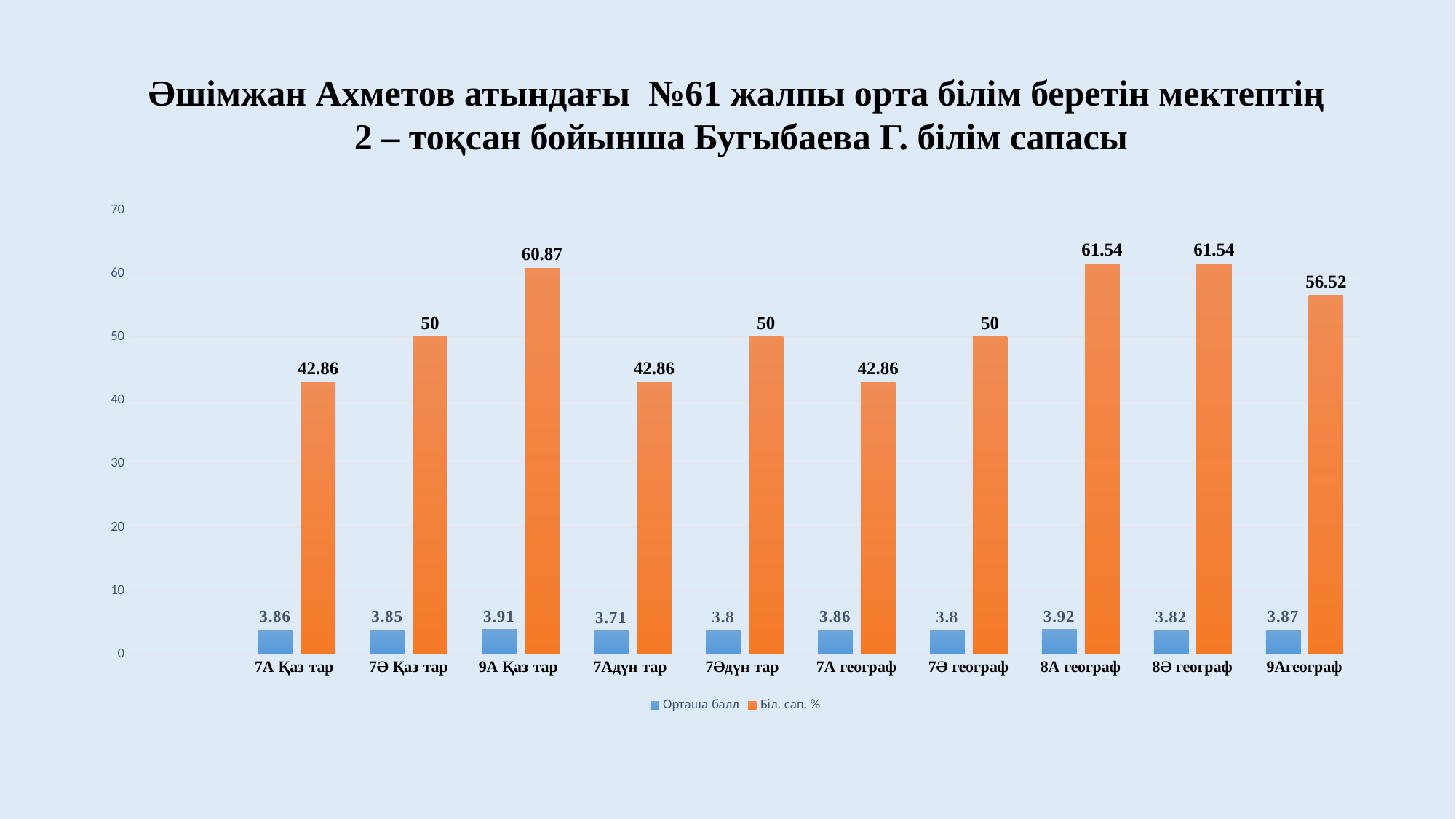
Is the Біл. сап. % value for 7А географ greater or less than 50? less What is the Орташа балл value for 8А географ? 3.92 Which is larger, the Біл. сап. % value for 9А Қаз тар or for 7Ә Қаз тар? 9А Қаз тар What type of chart is shown on the slide? bar chart What is the Біл. сап. % value for 9А Қаз тар? 60.87 How many categories are shown on the x axis? 10 What colour are the bars for the Біл. сап. % series? orange What is the Біл. сап. % value for 9Агеограф? 56.52 How many series does the legend list? 2 Which category has the lowest Орташа балл value? 7Адүн тар What is the Орташа балл value for 7Адүн тар? 3.71 What is the difference between the Біл. сап. % values for 8А географ and 9Агеограф? 5.02